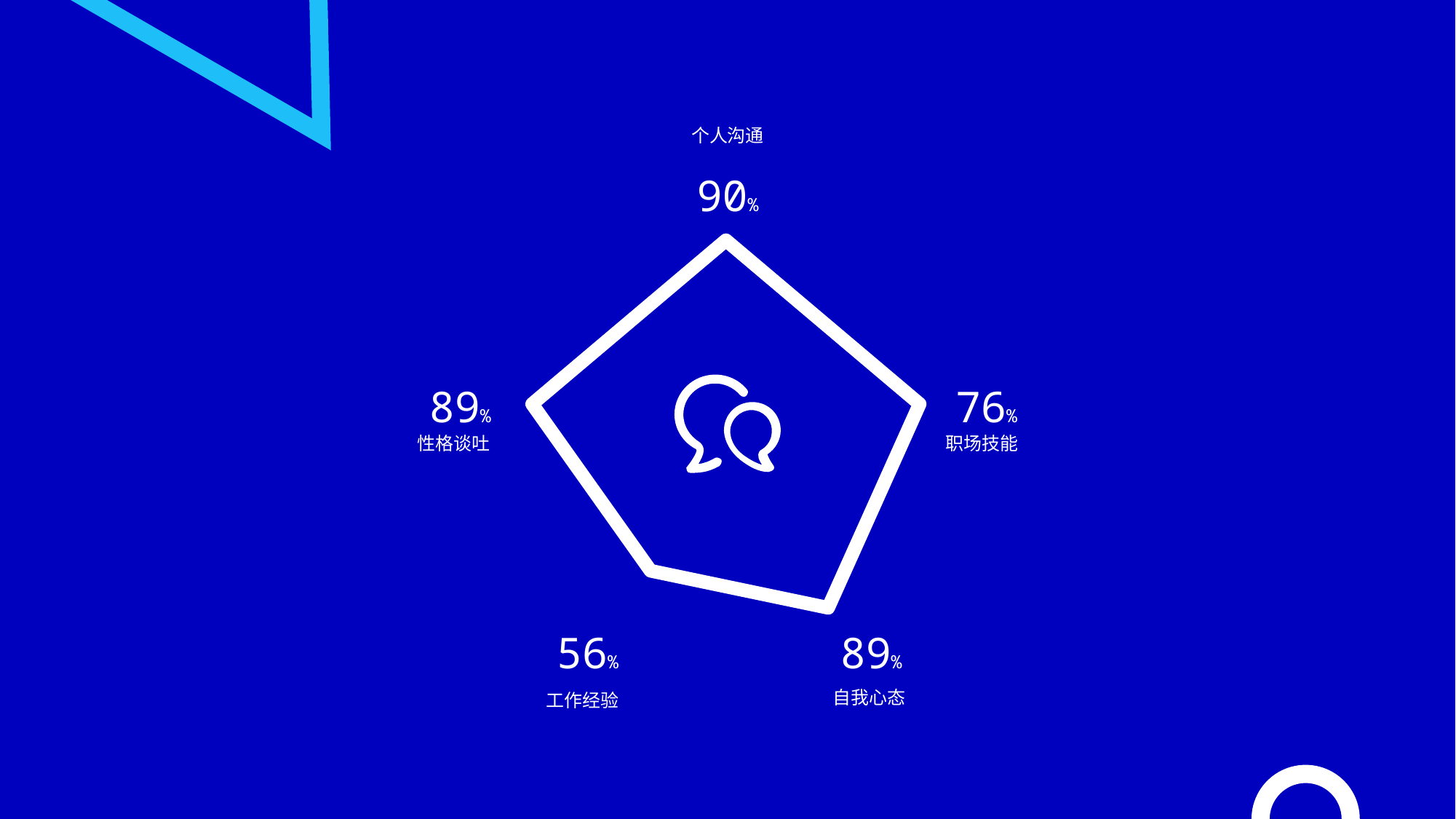
What is the value for 工作经验? 56% What is the value for 职场技能? 76% Which is larger, the value for 职场技能 or the value for 自我心态? 自我心态 What is the value for 自我心态? 89% What is the value for 个人沟通? 90% What is the difference between the values for 个人沟通 and 工作经验? 34 percentage points How many categories are shown on the chart? 5 Which category has the highest value? 个人沟通 Which category has the lowest value? 工作经验 What is the value for 性格谈吐? 89% What is the difference between the values for 性格谈吐 and 职场技能? 13 percentage points What kind of chart is shown on the slide? Radar chart